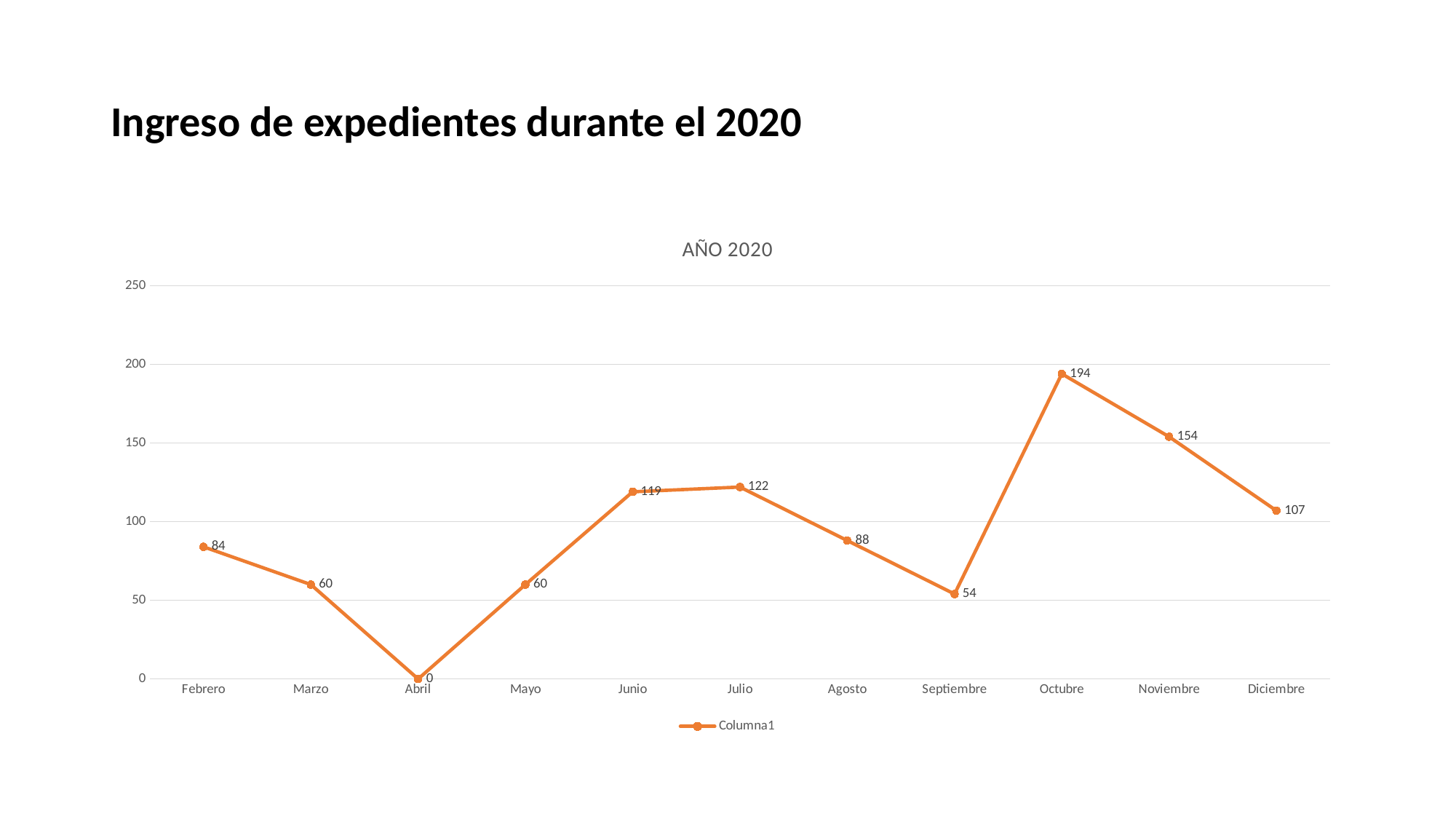
What kind of chart is shown? line chart What is the title shown above the chart area? AÑO 2020 How many months are plotted on the x axis? 11 How many series does the legend list? 1 What is the value for Febrero? 84 Which month has the highest value? Octubre What is the value for Octubre? 194 Which is larger, the value for Junio or the value for Julio? Julio Is the value for Diciembre greater or less than 100? greater What is the value for Septiembre? 54 What is the difference between the values for Octubre and Noviembre? 40 Which month has the lowest value? Abril